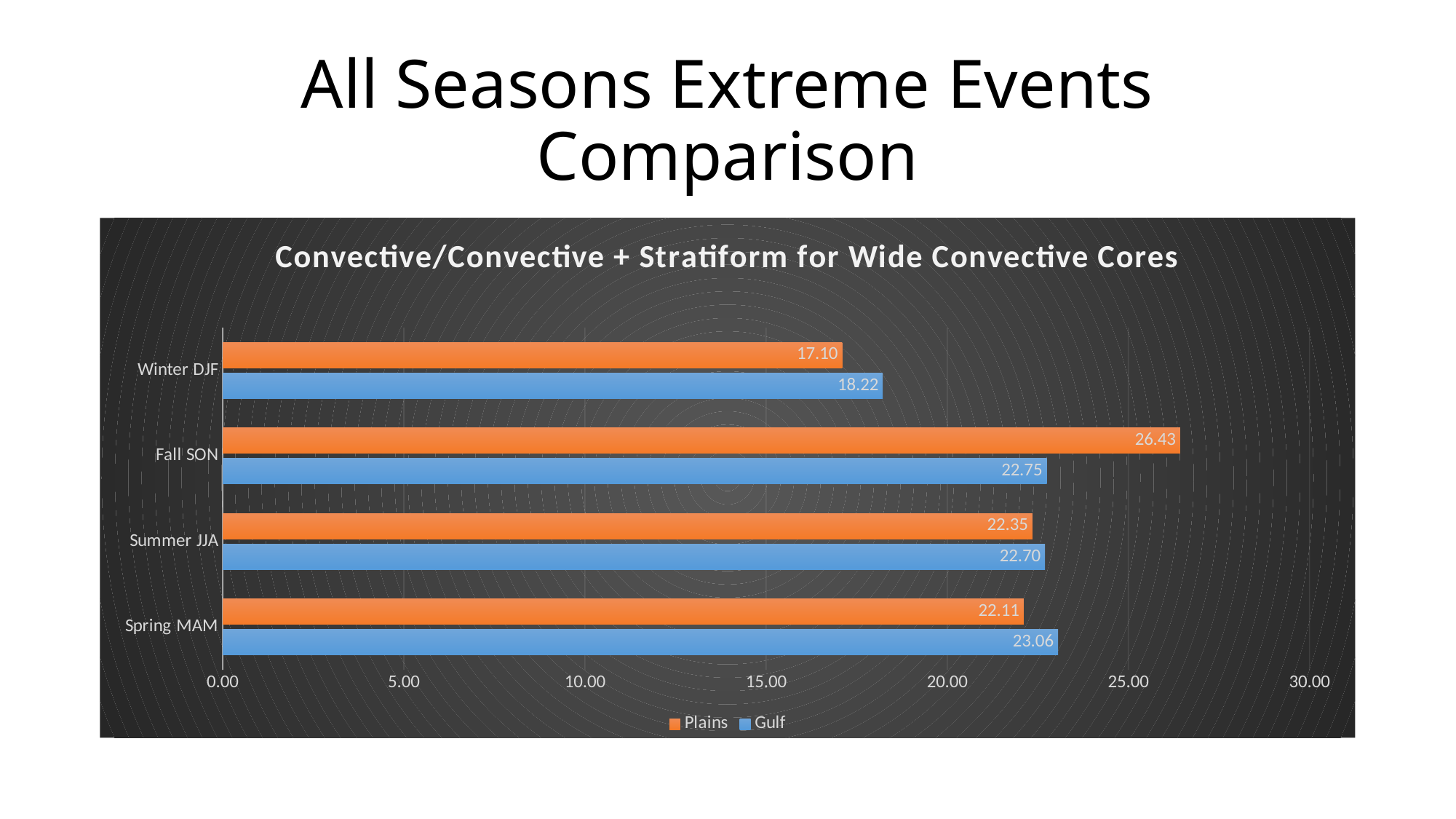
How many series does the legend list? 2 How many seasons are shown on the chart? 4 Is the Plains value for Winter DJF greater or less than 20.00? less Which season has the highest Plains value? Fall SON What is the title of the chart? Convective/Convective + Stratiform for Wide Convective Cores What is the Plains value for Fall SON? 26.43 What kind of chart is shown on the slide? bar chart For Winter DJF, which series has the larger value, Plains or Gulf? Gulf What is the difference between the Plains and Gulf values for Fall SON? 3.68 What is the Gulf value for Winter DJF? 18.22 Which season has the lowest Gulf value? Winter DJF What is the Gulf value for Spring MAM? 23.06